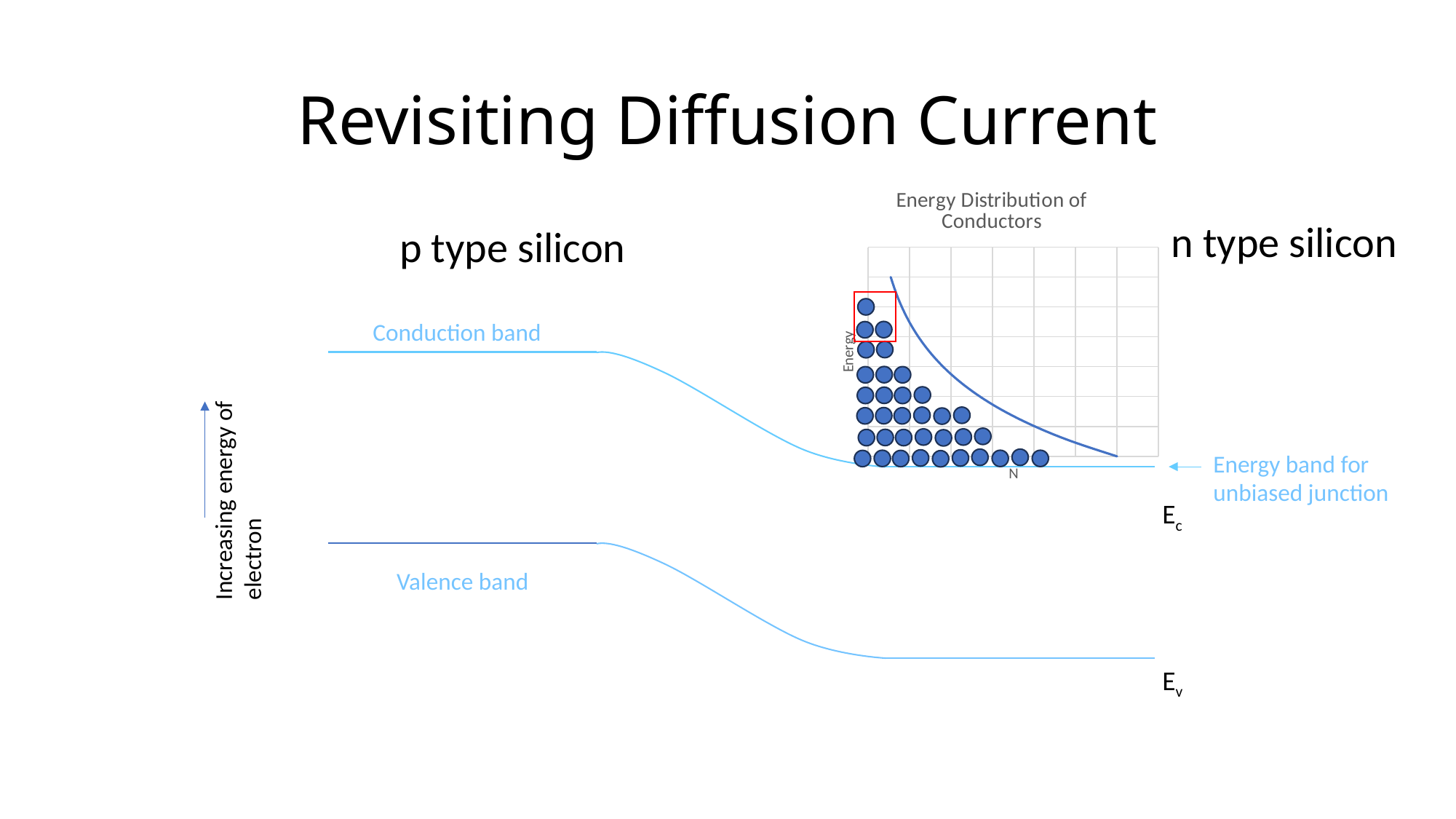
What is the label on the horizontal axis of the 'Energy Distribution of Conductors' chart? N In the 'Energy Distribution of Conductors' chart, does the curve rise or fall as you move along the x axis? fall What is the title of the chart on the slide? Energy Distribution of Conductors What kind of chart is the 'Energy Distribution of Conductors' chart? line chart How many circles are in the bottom row of the 'Energy Distribution of Conductors' chart? 10 How many circles are enclosed by the red box in the 'Energy Distribution of Conductors' chart? 3 What is the label on the vertical axis of the 'Energy Distribution of Conductors' chart? Energy